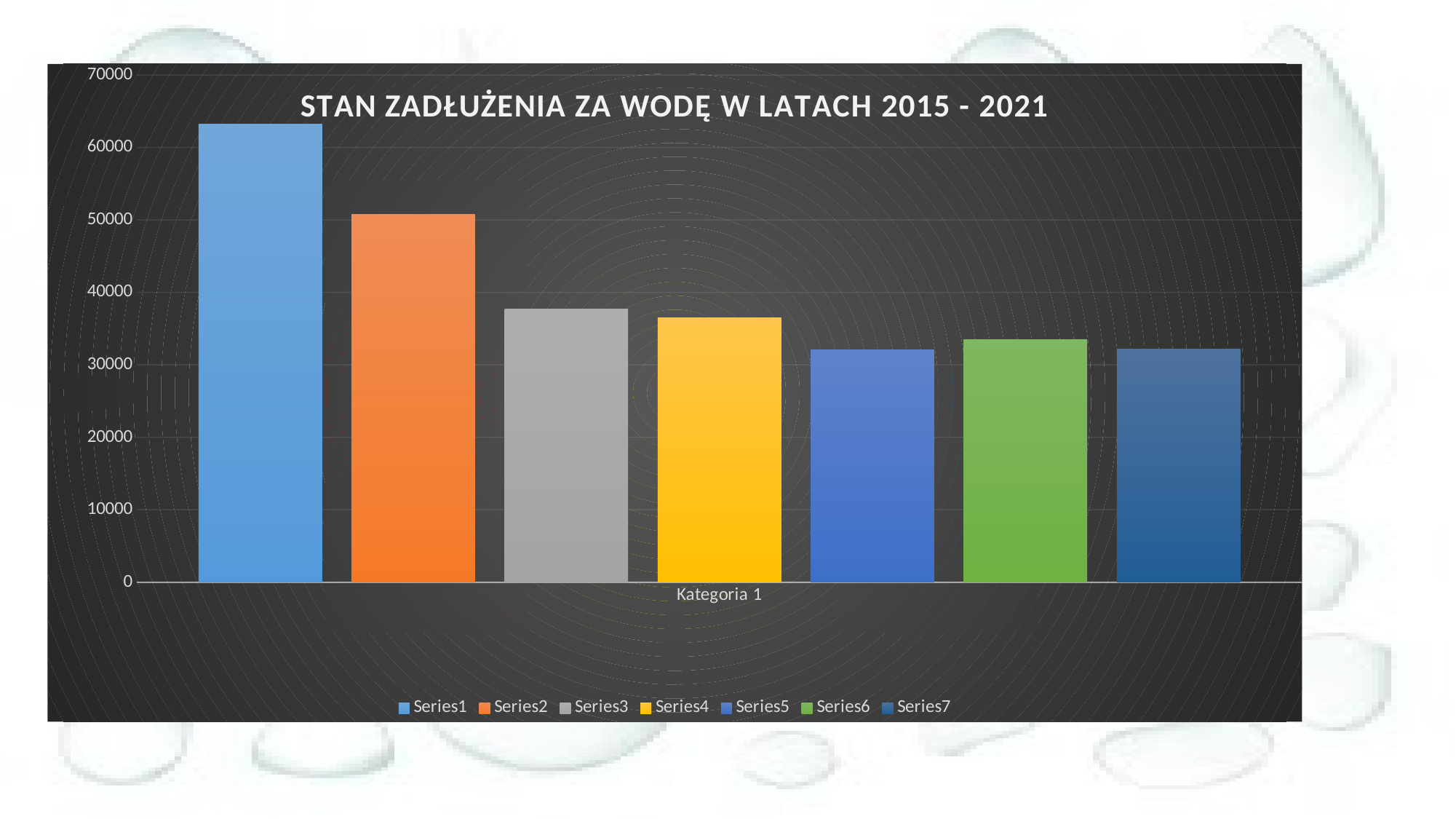
What kind of chart is shown on the slide? bar chart Which series has the highest value? Series1 Is the value for Series1 greater or less than 60000? greater How many categories are shown on the x axis? 1 What is the title of the chart? STAN ZADŁUŻENIA ZA WODĘ W LATACH 2015 - 2021 Which is larger, the value for Series1 or the value for Series2? Series1 Is the value for Series5 greater or less than 30000? greater What is the label of the category on the x axis? Kategoria 1 Is the value for Series2 greater or less than 40000? greater Which is larger, the value for Series2 or the value for Series3? Series2 How many series does the legend list? 7